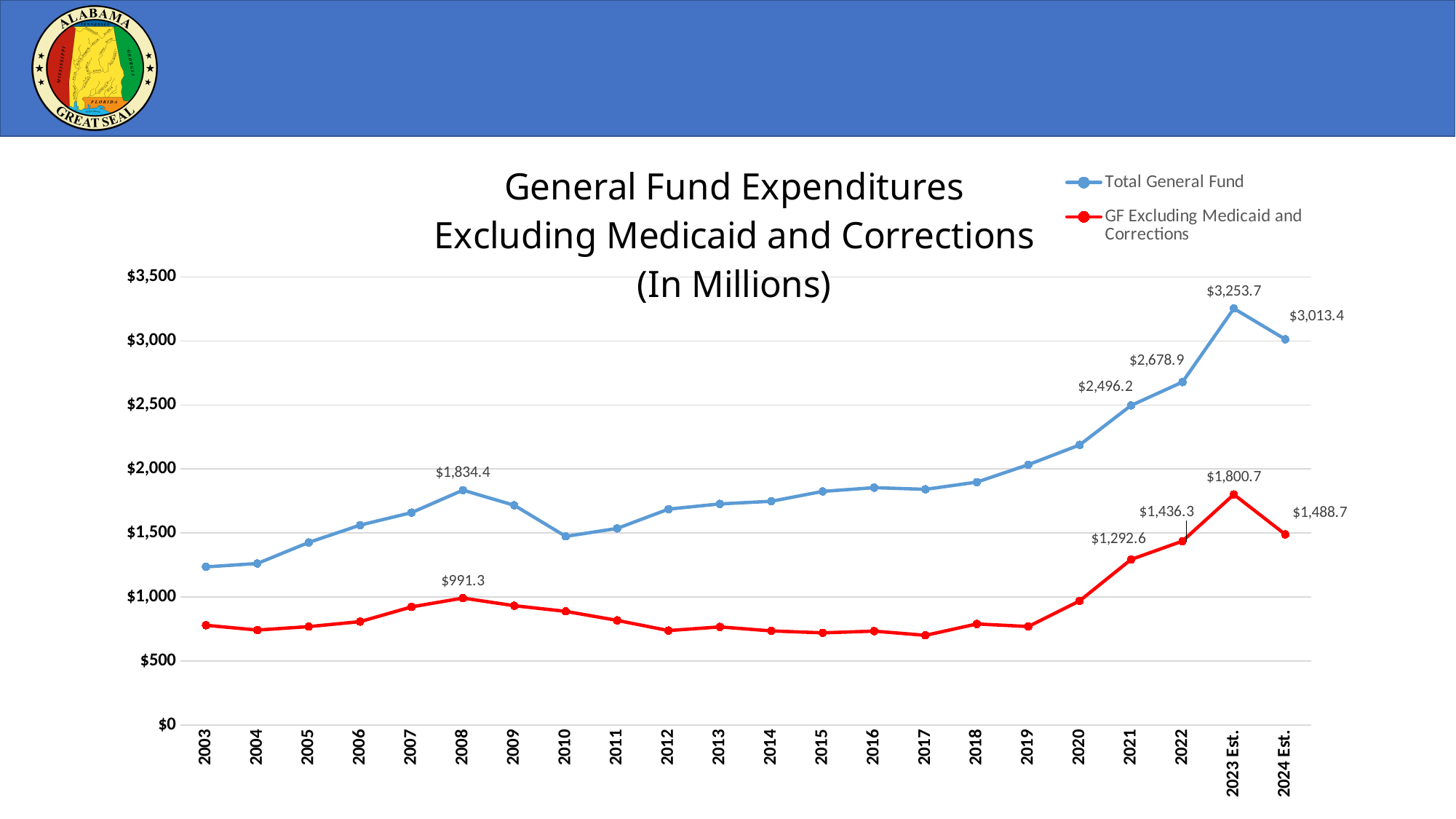
How many series does the legend list? 2 For GF Excluding Medicaid and Corrections, which is larger: 2023 Est. or 2024 Est.? 2023 Est. By how much did the Total General Fund increase from 2021 to 2022? $182.7 Is the Total General Fund value for 2003 greater or less than $1,500? less How many years are shown on the x axis? 22 What is the GF Excluding Medicaid and Corrections value for 2008? $991.3 In which year does the Total General Fund series reach its highest value? 2023 Est. What type of chart is shown on the slide? line chart Is the GF Excluding Medicaid and Corrections value for 2017 greater or less than $1,000? less What is the GF Excluding Medicaid and Corrections value for 2022? $1,436.3 What is the Total General Fund value for 2023 Est.? $3,253.7 What is the difference between the Total General Fund and GF Excluding Medicaid and Corrections values in 2023 Est.? $1,453.0